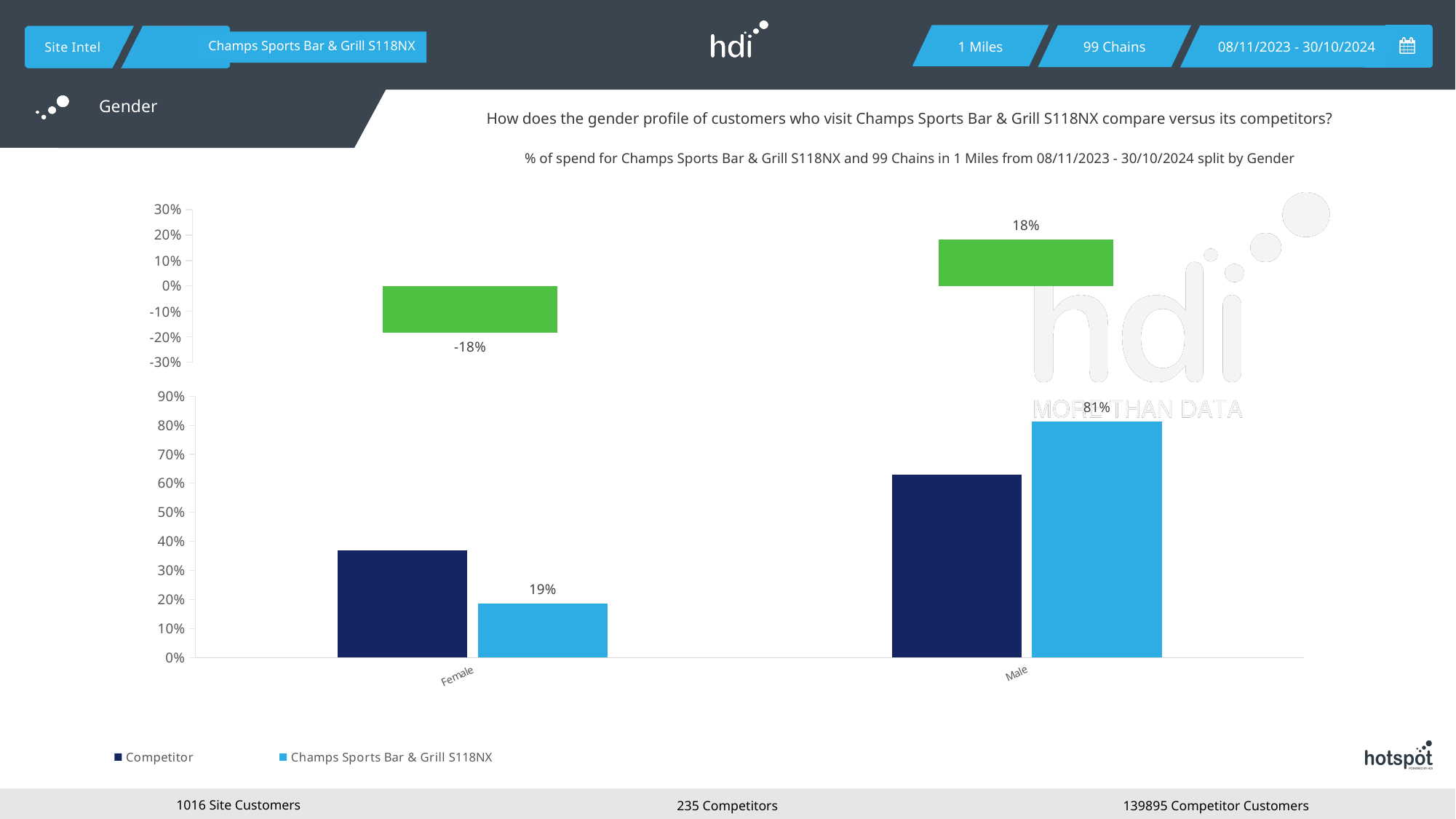
In the bottom chart, is the Competitor value for Female greater or less than 30%? greater In the bottom chart, for Male, which is larger: the Competitor value or the Champs Sports Bar & Grill S118NX value? Champs Sports Bar & Grill S118NX In the bottom chart, what is the value for Champs Sports Bar & Grill S118NX for Male? 81% In the bottom chart, what is the difference between the Champs Sports Bar & Grill S118NX values for Male and Female? 62% In the bottom chart, which gender category has the highest value for Champs Sports Bar & Grill S118NX? Male In the bottom chart, for Female, which is larger: the Competitor value or the Champs Sports Bar & Grill S118NX value? Competitor In the bottom chart, is the Competitor value for Male greater or less than 70%? less In the top chart, what is the value shown for Female? -18% How many series does the legend of the bottom chart list? 2 In the bottom chart, what is the value for Champs Sports Bar & Grill S118NX for Female? 19% What type of chart is the bottom chart? Bar chart In the top chart, what is the value shown for Male? 18%